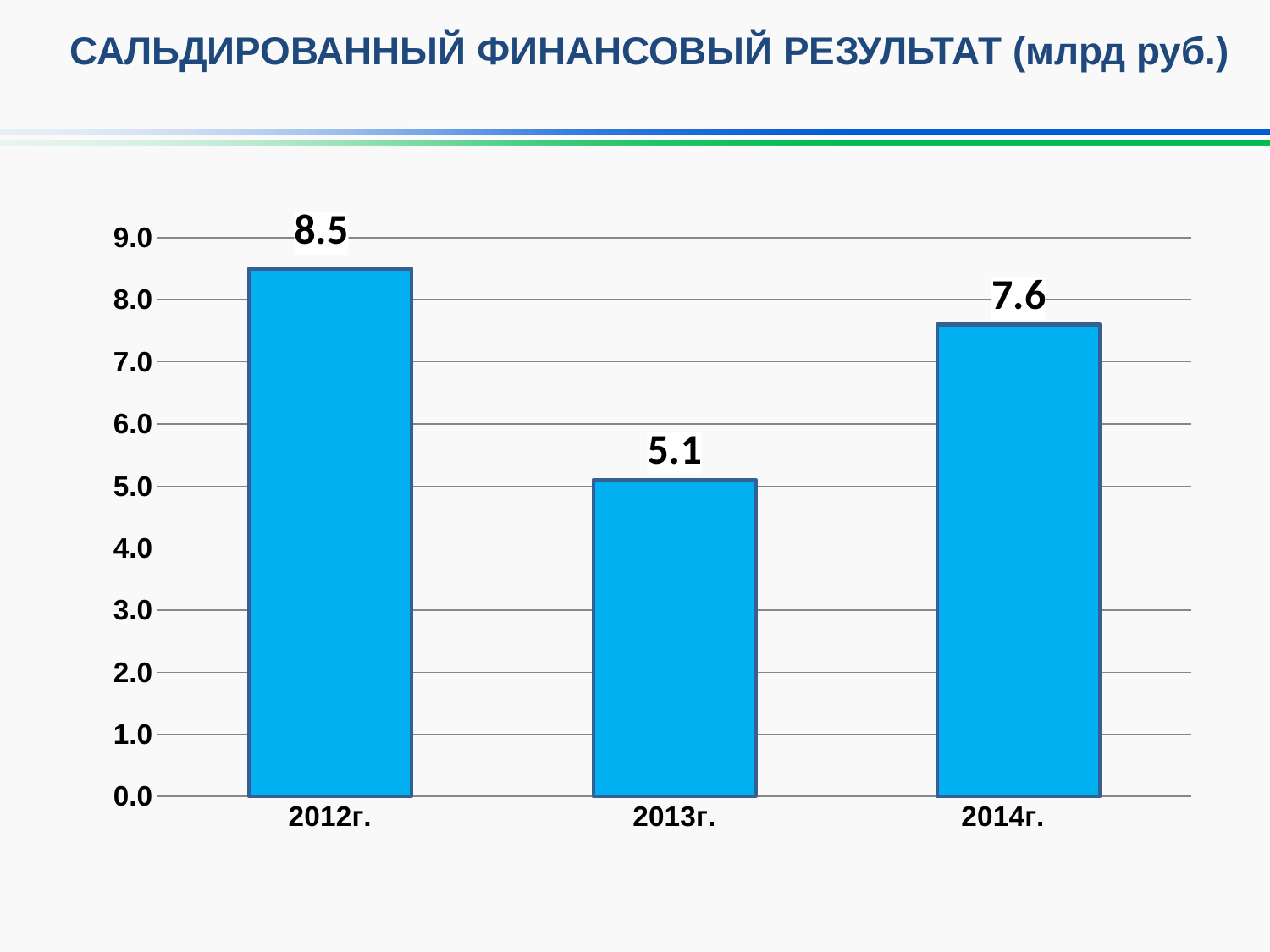
What is the title of the chart? САЛЬДИРОВАННЫЙ ФИНАНСОВЫЙ РЕЗУЛЬТАТ (млрд руб.) Which year has the highest value? 2012г. What is the difference between the values for 2014г. and 2013г.? 2.5 Which is larger, the value for 2012г. or the value for 2014г.? 2012г. What is the difference between the values for 2012г. and 2013г.? 3.4 What is the value for 2012г.? 8.5 What is the value for 2014г.? 7.6 Which year has the lowest value? 2013г. What is the value for 2013г.? 5.1 Is the value for 2013г. greater or less than 6.0? less How many years are shown on the chart? 3 What kind of chart is shown on the slide? bar chart